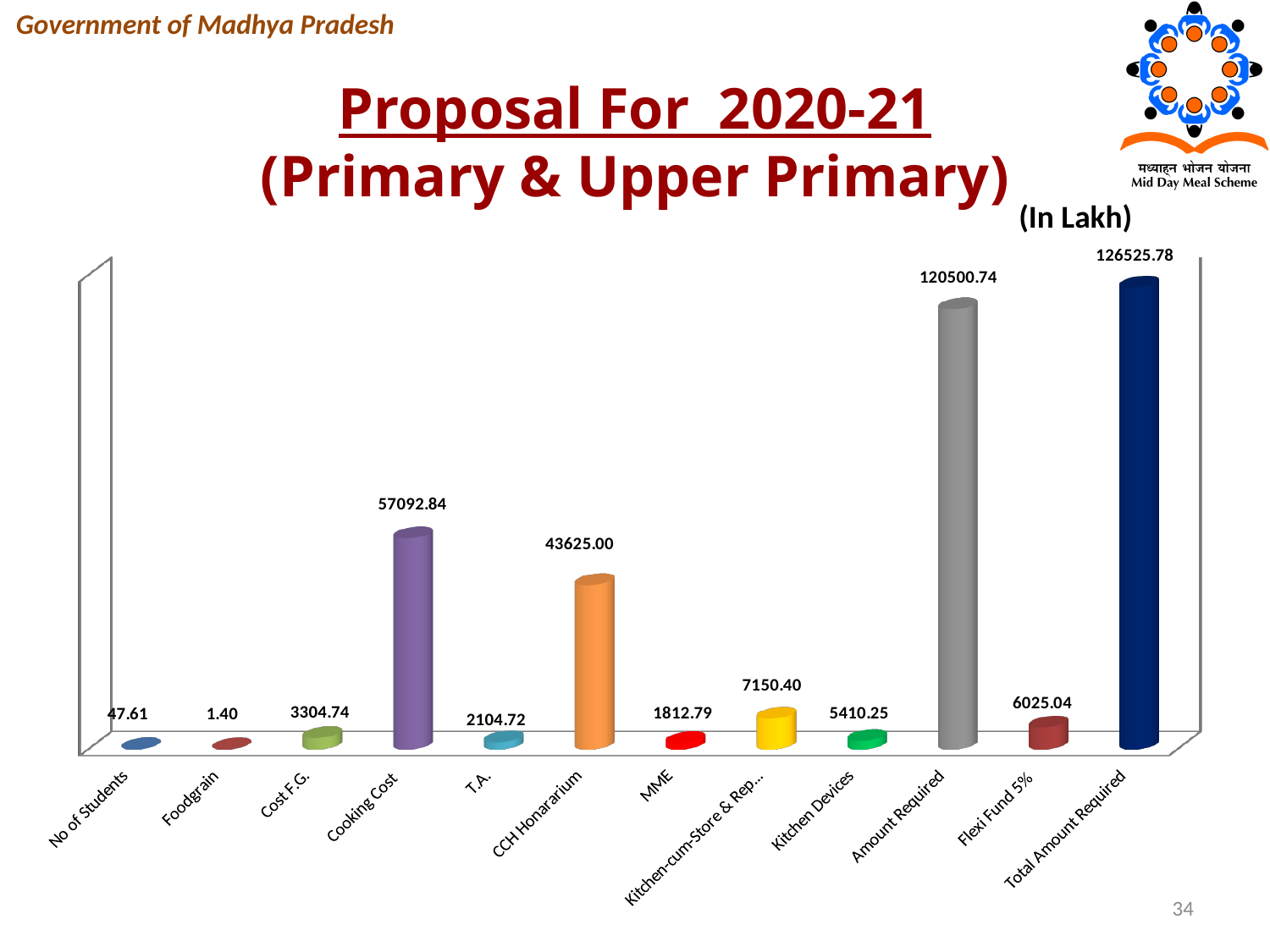
Which category has the highest value? Total Amount Required What is the value for Cooking Cost? 57092.84 Which category has the lowest value? Foodgrain How many categories are shown in the chart? 12 What is the value for Kitchen Devices? 5410.25 What is the difference between Cooking Cost and CCH Honararium? 13467.84 Which is larger, T.A. or MME? T.A. What is the value for Foodgrain? 1.40 What is the difference between Total Amount Required and Amount Required? 6025.04 What is the value for Flexi Fund 5%? 6025.04 What kind of chart is shown on the slide? Bar chart What is the value for CCH Honararium? 43625.00